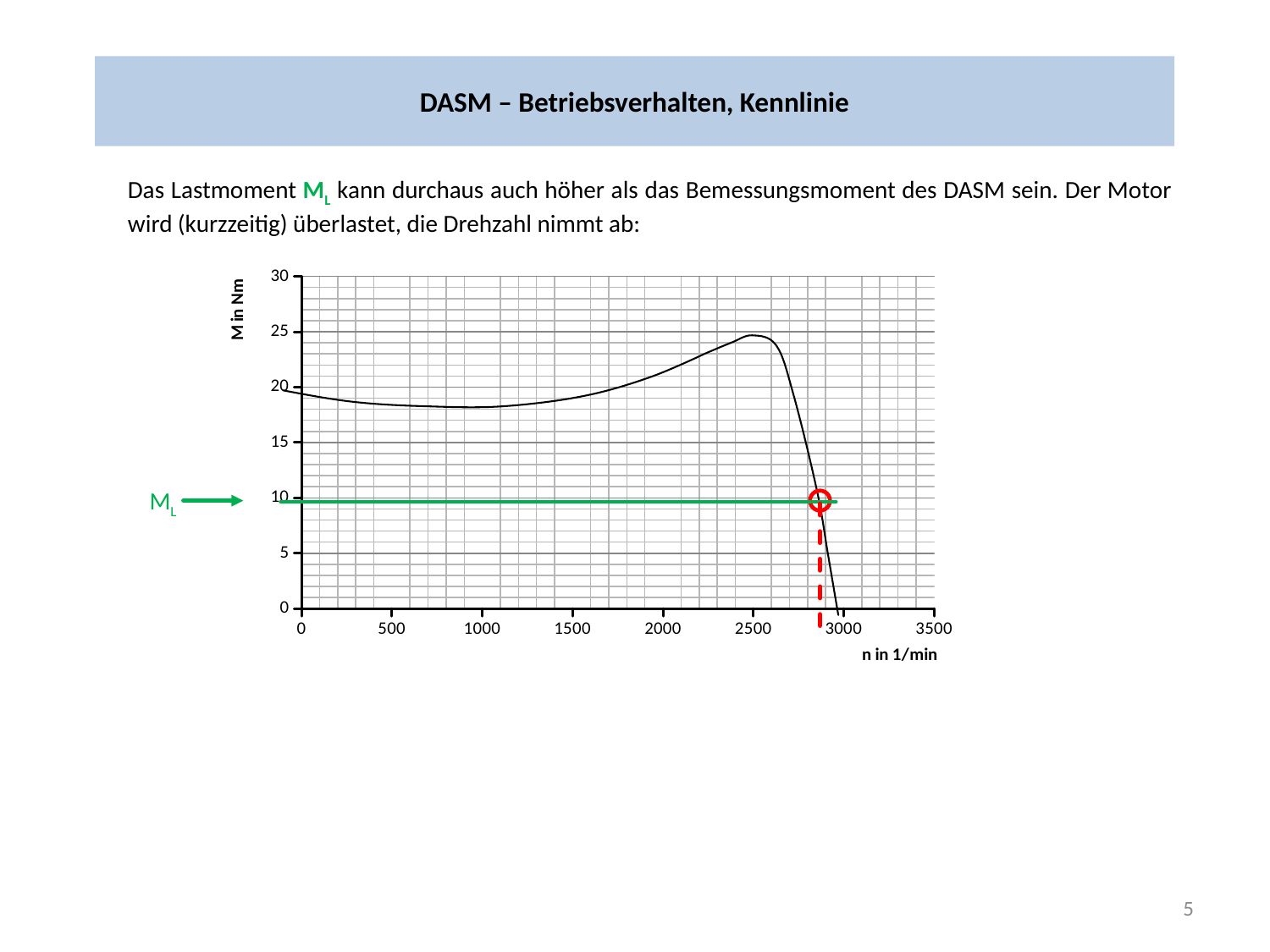
Is the load torque M_L (green line) greater or less than 15? less What is the label of the y axis of the chart? M in Nm Does the curve rise or fall between n = 1000 and n = 2500? rise Does the curve rise or fall between n = 2500 and n = 3000? fall What kind of chart is shown on the slide? line chart Is the value of the curve at n = 2500 greater or less than 20? greater Is the value of the curve at n = 0 greater or less than 15? greater Is the curve value at n = 2500 larger or smaller than at n = 1000? larger What is the highest value shown on the x axis? 3500 What is the label of the x axis of the chart? n in 1/min